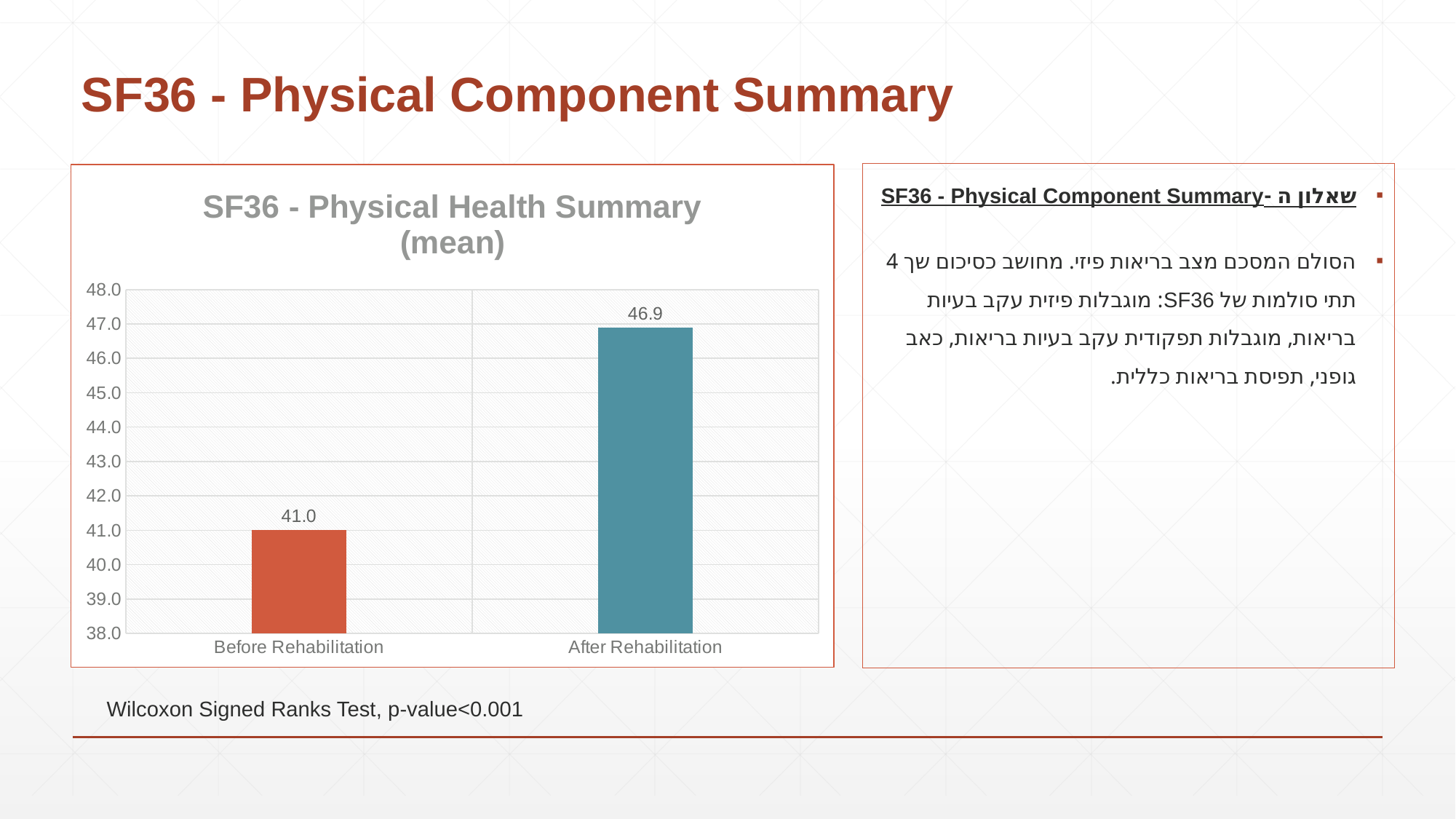
What is the difference between the After Rehabilitation and Before Rehabilitation values? 5.9 What is the title of the chart? SF36 - Physical Health Summary (mean) What kind of chart is shown on the slide? Bar chart Which category has the highest value? After Rehabilitation Which category has the lowest value? Before Rehabilitation How many categories are shown on the chart? 2 Do the values rise or fall from Before Rehabilitation to After Rehabilitation? Rise What is the value for Before Rehabilitation? 41.0 Is the value for Before Rehabilitation greater or less than 42.0? less Is the value for After Rehabilitation greater or less than 45.0? greater What is the value for After Rehabilitation? 46.9 Which is larger, the value for Before Rehabilitation or After Rehabilitation? After Rehabilitation